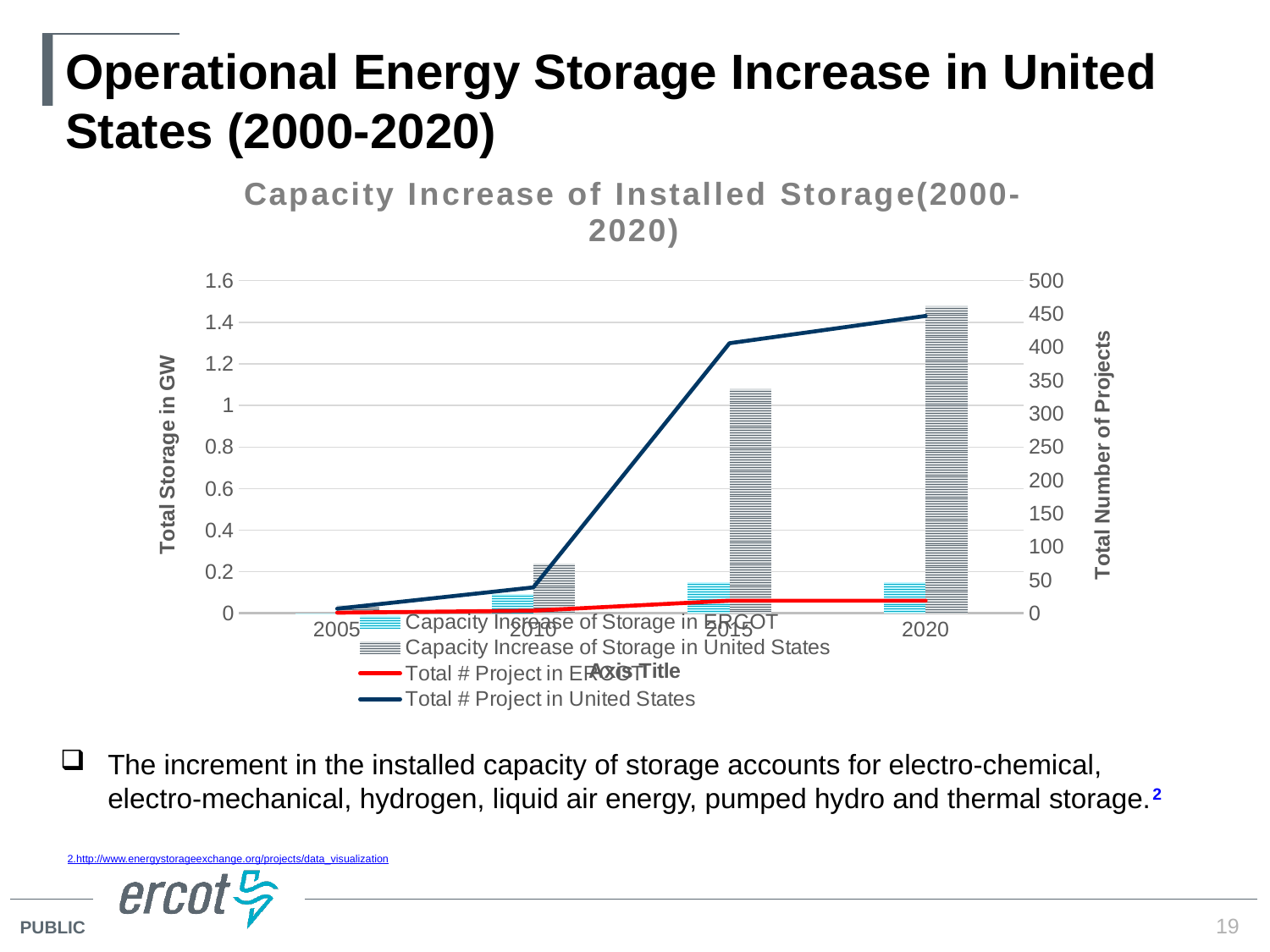
In which year is the Capacity Increase of Storage in United States bar the highest? 2020 In 2020, which is larger: Total # Project in United States or Total # Project in ERCOT? Total # Project in United States Does the Total # Project in United States line rise or fall from 2005 to 2020? rise How many years are shown on the x axis of the chart? 4 Is the Capacity Increase of Storage in United States for 2010 greater or less than 0.4 GW? less What is the title of the left vertical axis of the chart? Total Storage in GW What kind of chart is shown on the slide? bar and line chart Is the Capacity Increase of Storage in United States for 2020 greater or less than 1.2 GW? greater Which year has the larger Capacity Increase of Storage in United States, 2015 or 2020? 2020 In which year is the Capacity Increase of Storage in United States bar the lowest? 2005 How many series does the chart's legend list? 4 Is the Total # Project in United States for 2020 greater or less than 400? greater